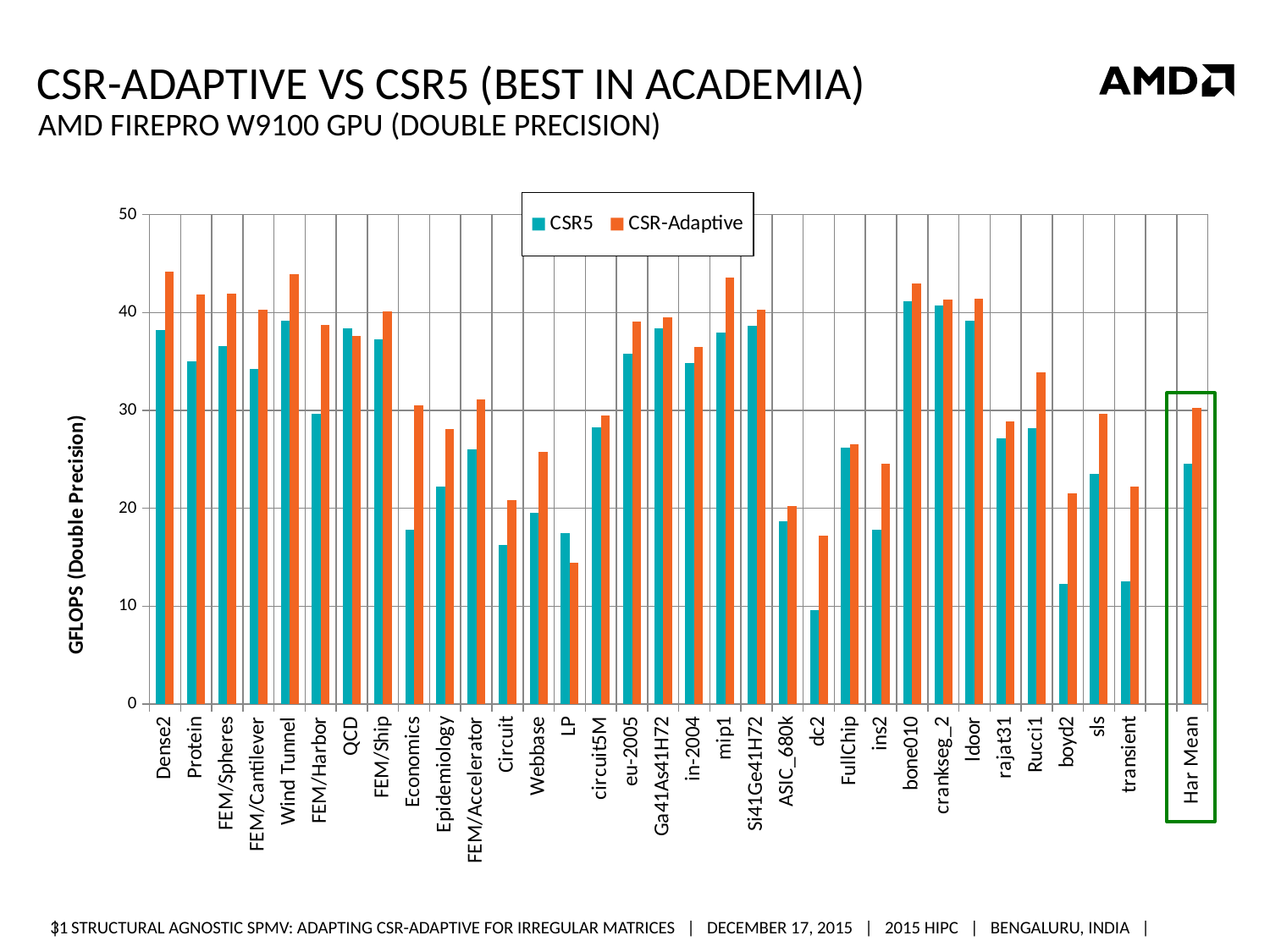
What kind of chart is shown on the slide? bar chart Is the CSR5 value for dc2 greater or less than 10? less What is the label of the y axis? GFLOPS (Double Precision) What are the two series named in the legend? CSR5 and CSR-Adaptive How many series does the legend list? 2 For LP, which series has the larger value, CSR5 or CSR-Adaptive? CSR5 For Economics, which series has the larger value, CSR5 or CSR-Adaptive? CSR-Adaptive How many categories are shown along the x axis, including Har Mean? 33 Which category has the lowest CSR5 value? dc2 Is the CSR5 value for Har Mean greater or less than 30? less Is the CSR-Adaptive value for Dense2 greater or less than 40? greater Which category has the lowest CSR-Adaptive value? LP